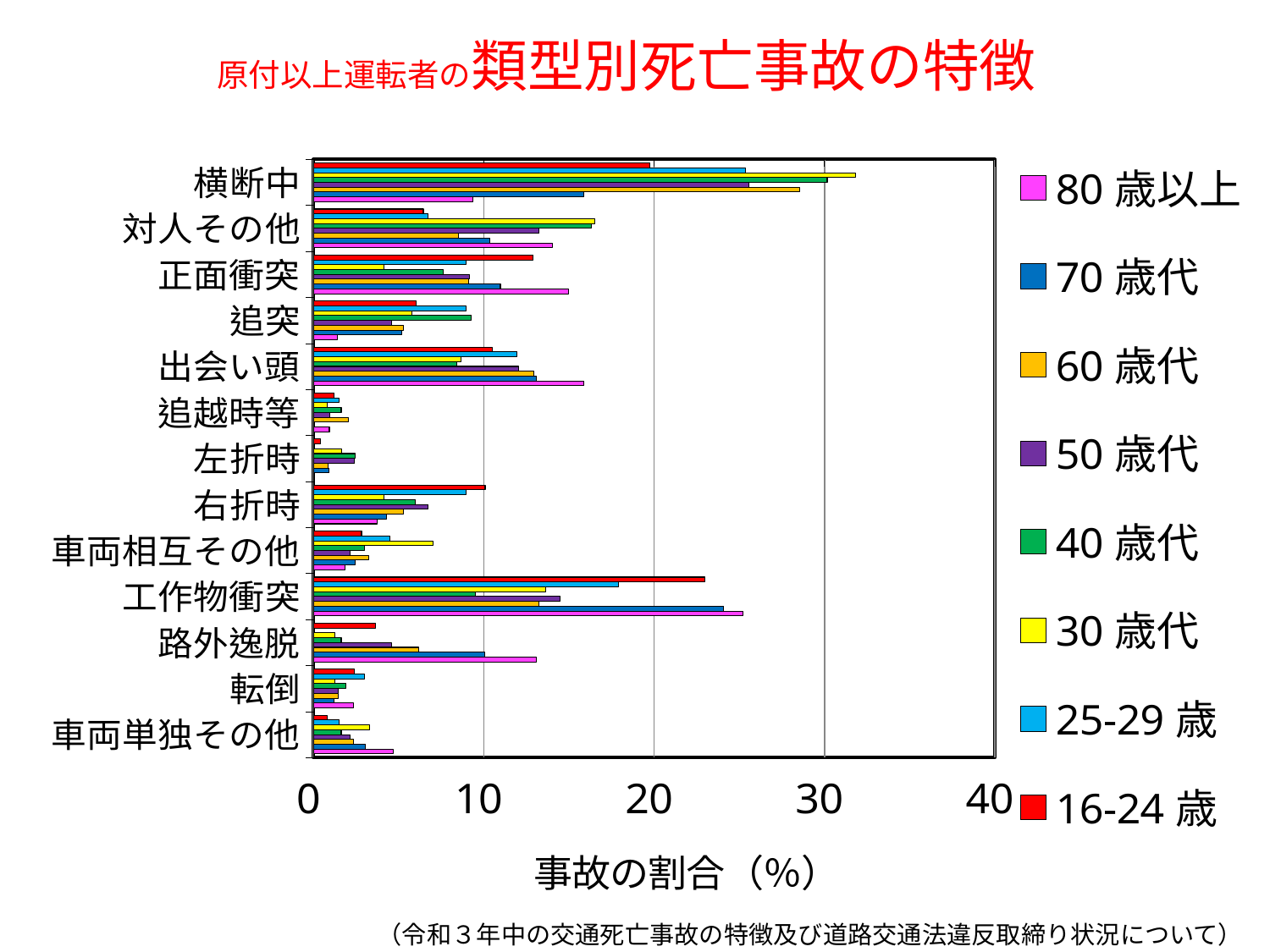
Is the value for 工作物衝突 in the 16-24 歳 series greater or less than 20? greater Is the value for 出会い頭 in the 80 歳以上 series greater or less than 10? greater What is the label of the horizontal axis? 事故の割合（%） Which category has the highest value for the 16-24 歳 series? 工作物衝突 Is the value for 横断中 in the 60 歳代 series greater or less than 30? less Which category has the highest value for the 60 歳代 series? 横断中 What kind of chart is shown on the slide? bar chart For the 80 歳以上 series, which is larger: 工作物衝突 or 横断中? 工作物衝突 How many accident-type categories are listed on the vertical axis? 13 How many age-group series does the legend list? 8 For 追突, which series has the larger value: 80 歳以上 or 16-24 歳? 16-24 歳